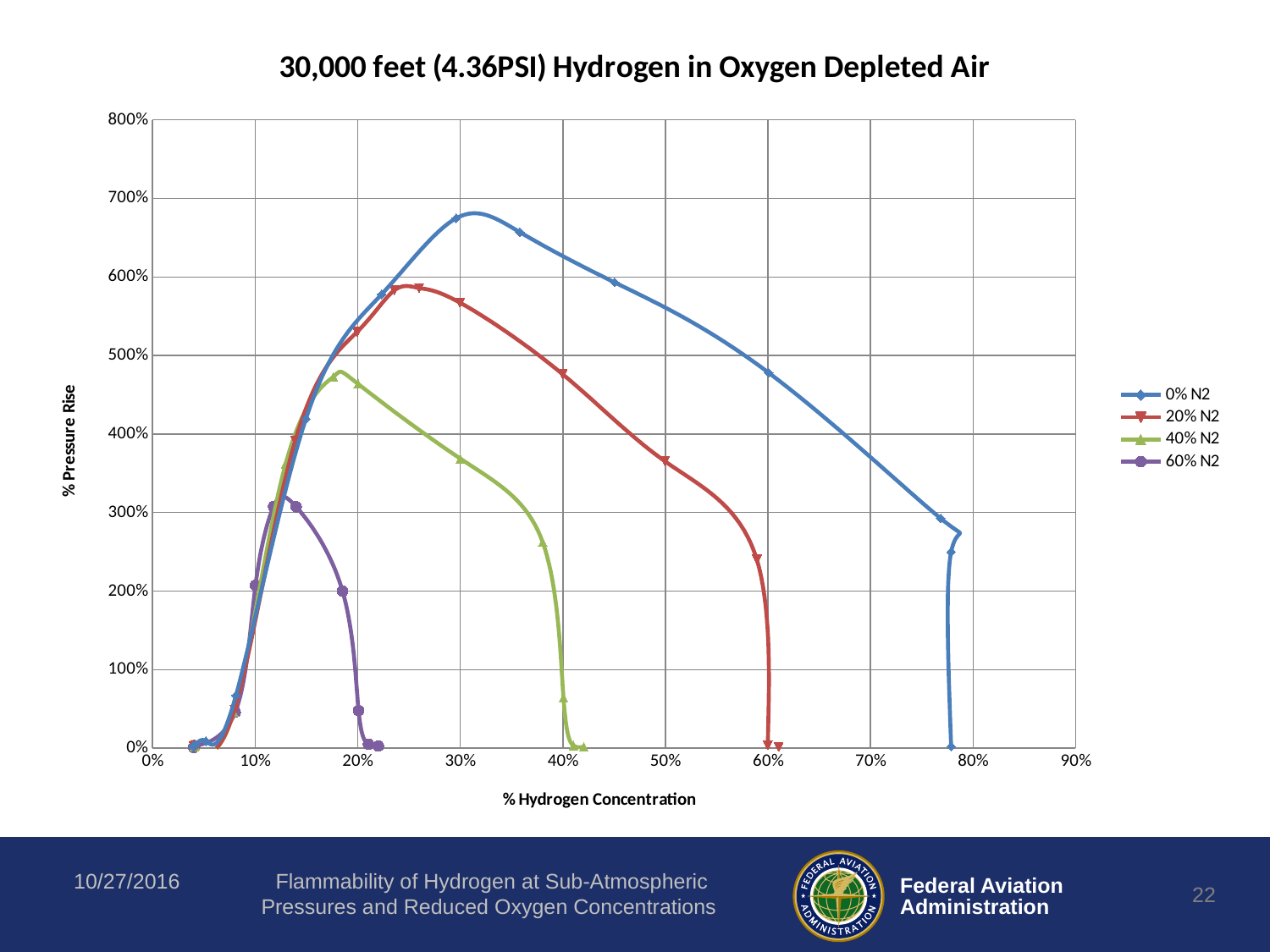
Is the peak value of the 60% N2 series greater or less than 400%? less Is the peak value of the 0% N2 series greater or less than 600%? greater For the 0% N2 series, do the values rise or fall as hydrogen concentration increases from 30% to 70%? fall What is the title of the chart? 30,000 feet (4.36PSI) Hydrogen in Oxygen Depleted Air Which series has the lowest peak % Pressure Rise? 60% N2 How many series does the legend list? 4 What kind of chart is shown on the slide? line chart Which series extends to the highest % Hydrogen Concentration before dropping to 0%? 0% N2 Which series has a higher peak % Pressure Rise, 20% N2 or 40% N2? 20% N2 What is the label of the x axis? % Hydrogen Concentration Which series reaches the highest % Pressure Rise? 0% N2 Is the peak value of the 40% N2 series greater or less than 400%? greater